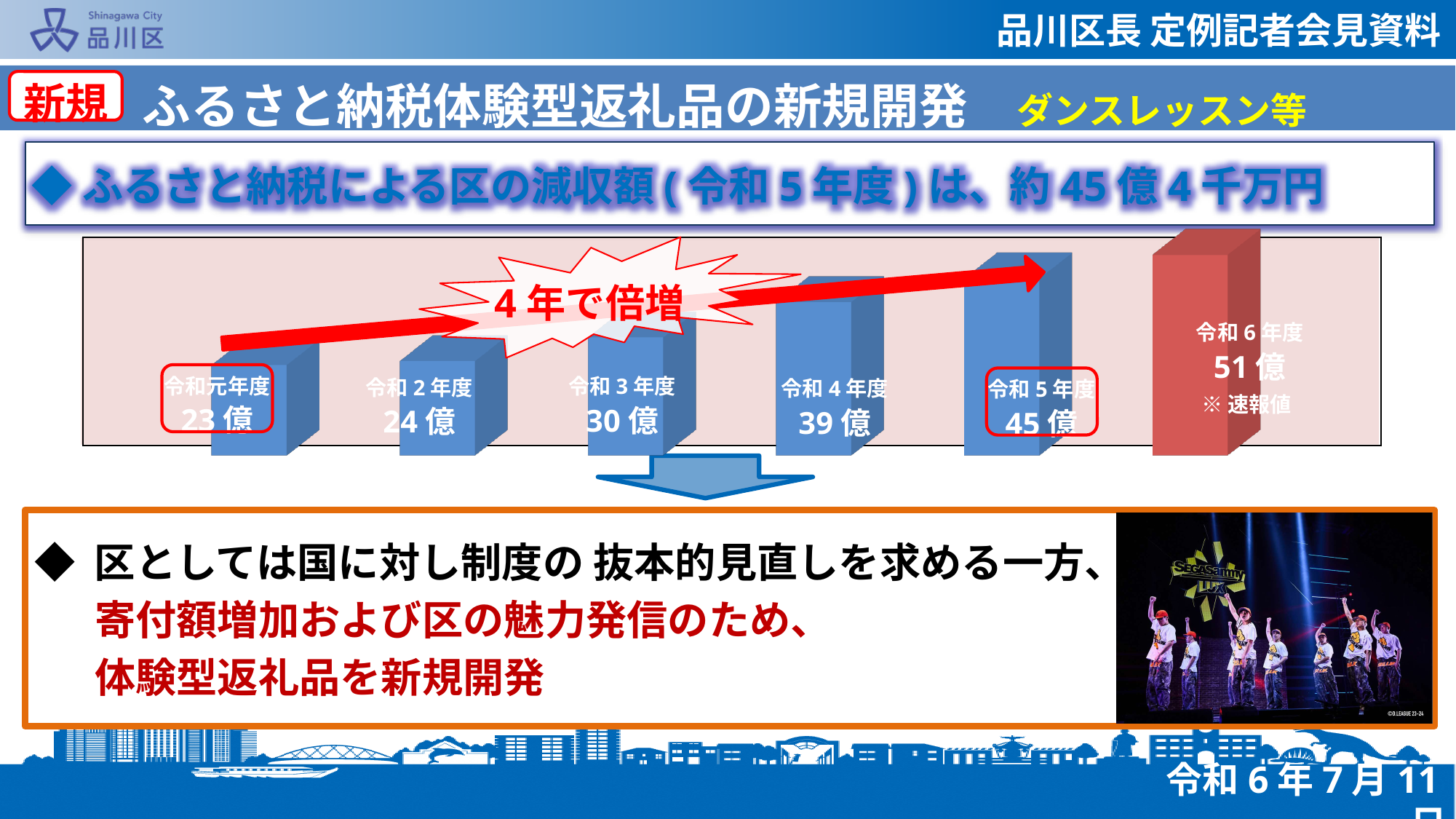
Do the values rise or fall from 令和元年度 to 令和6年度? Rise What is the difference between the values for 令和5年度 and 令和元年度? 22億 Which is larger, the value for 令和2年度 or the value for 令和4年度? 令和4年度 How many fiscal years are shown as bars in the chart? 6 What is the value shown for 令和6年度? 51億 What is the difference between the values for 令和4年度 and 令和3年度? 9億 What kind of chart is shown on the slide? Bar chart Which fiscal year has the highest value in the chart? 令和6年度 What is the value shown for 令和3年度? 30億 What is the value shown for 令和5年度? 45億 What is the value shown for 令和元年度? 23億 Which fiscal year has the lowest value in the chart? 令和元年度